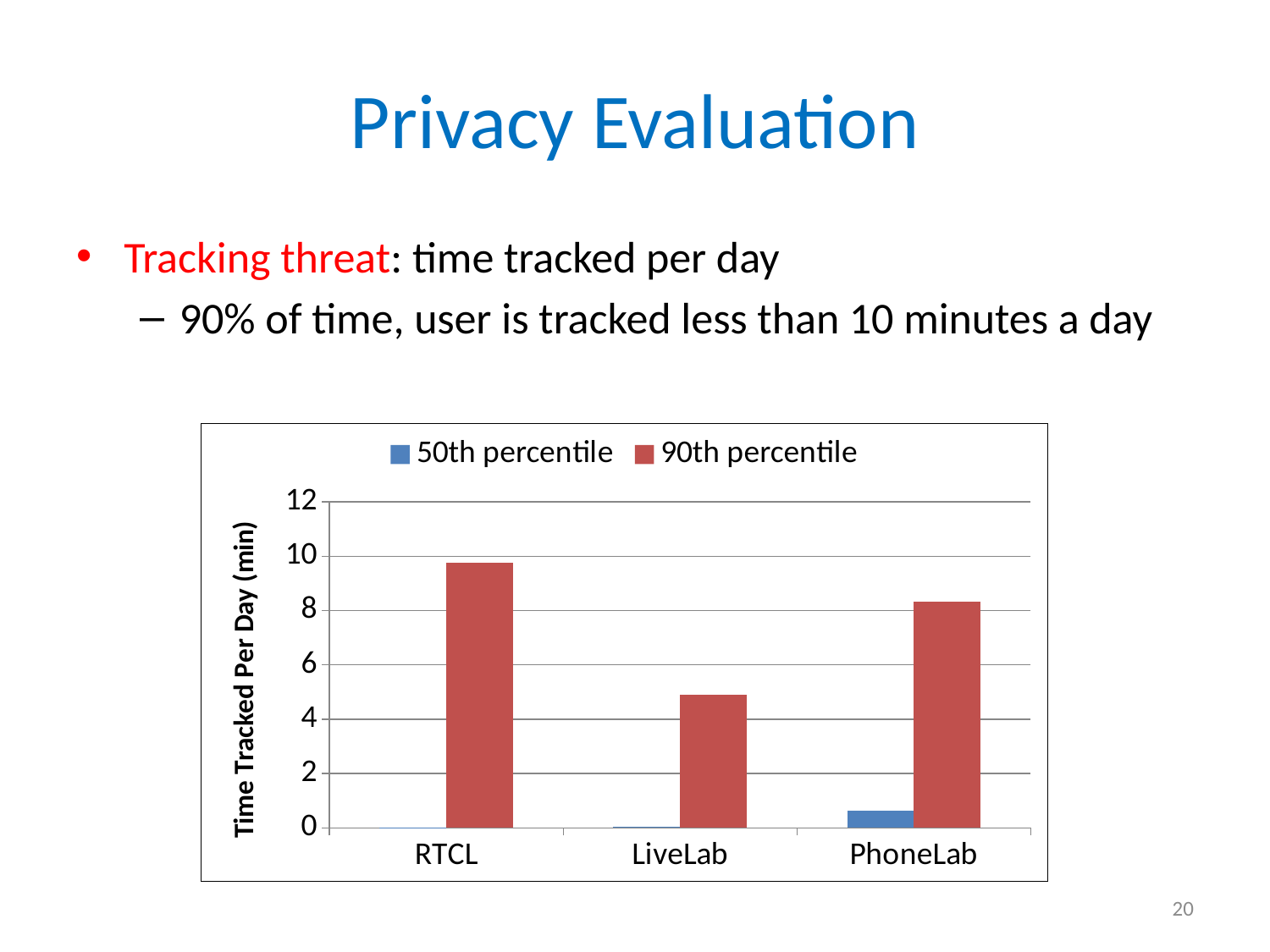
What is the label of the y axis? Time Tracked Per Day (min) What kind of chart is shown on the slide? bar chart How many series does the legend list? 2 Which category has the highest 50th percentile value? PhoneLab Which category has the highest 90th percentile value? RTCL Is the 90th percentile value for RTCL greater or less than 8? greater Which is larger, the 90th percentile value for PhoneLab or for LiveLab? PhoneLab Which category has the lowest 90th percentile value? LiveLab How many categories are shown on the x axis? 3 What colour are the 90th percentile bars? red Is the 90th percentile value for LiveLab greater or less than 6? less Is the 90th percentile value for PhoneLab greater or less than 10? less